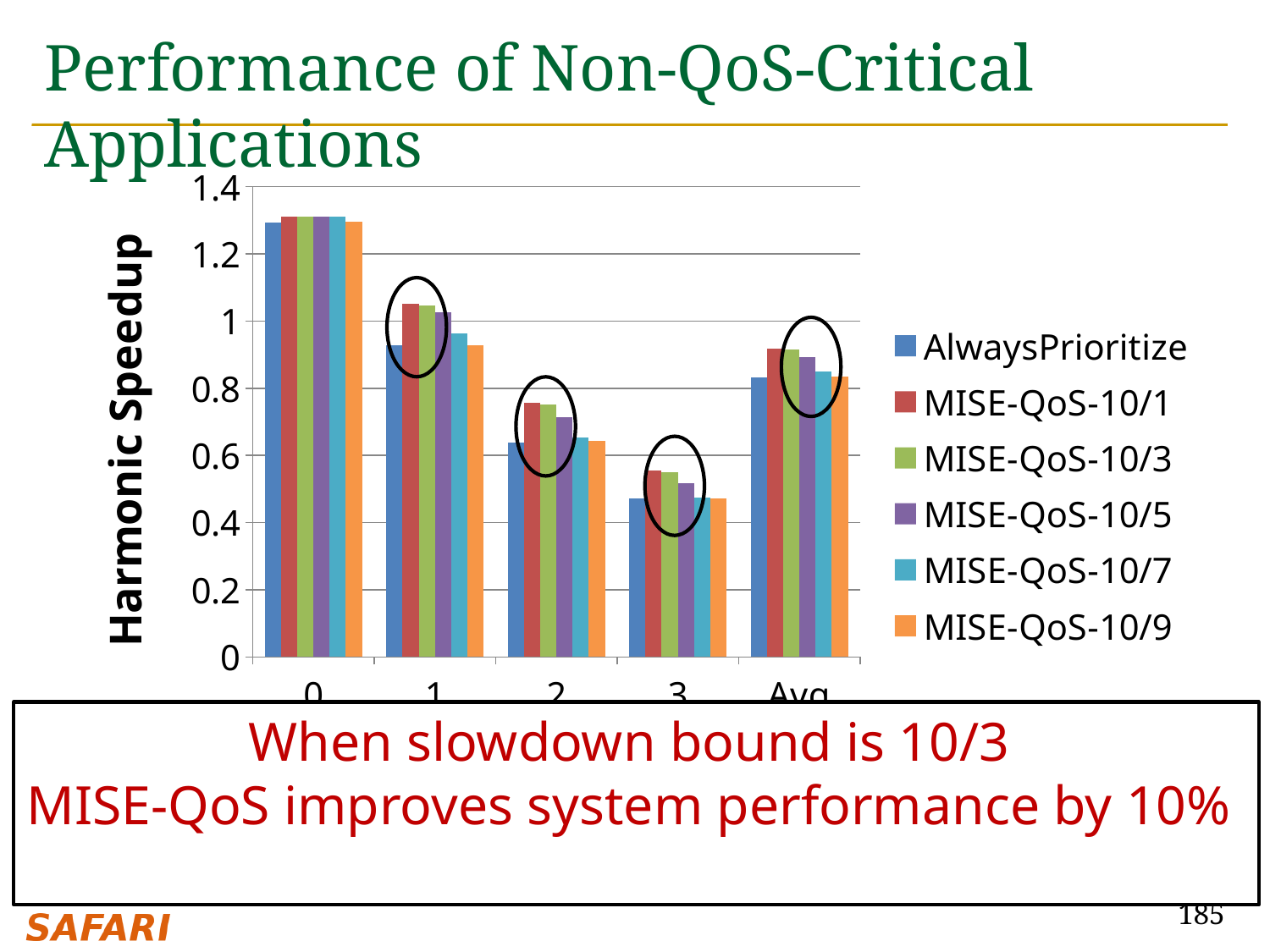
Is the AlwaysPrioritize value for category 3 greater or less than 0.6? less How many series does the legend list? 6 What is the label of the y axis? Harmonic Speedup Is the MISE-QoS-10/1 value for category 2 greater or less than 0.8? less For category 1, which is larger: the AlwaysPrioritize value or the MISE-QoS-10/1 value? MISE-QoS-10/1 What kind of chart is shown on the slide? bar chart Which category has the highest Harmonic Speedup for the AlwaysPrioritize series? 0 Is the MISE-QoS-10/1 value for category 1 greater or less than 1? greater Which category has the lowest Harmonic Speedup for the MISE-QoS-10/1 series? 3 How many categories are shown along the x axis? 5 Do the AlwaysPrioritize values rise or fall from category 0 to category 3? fall